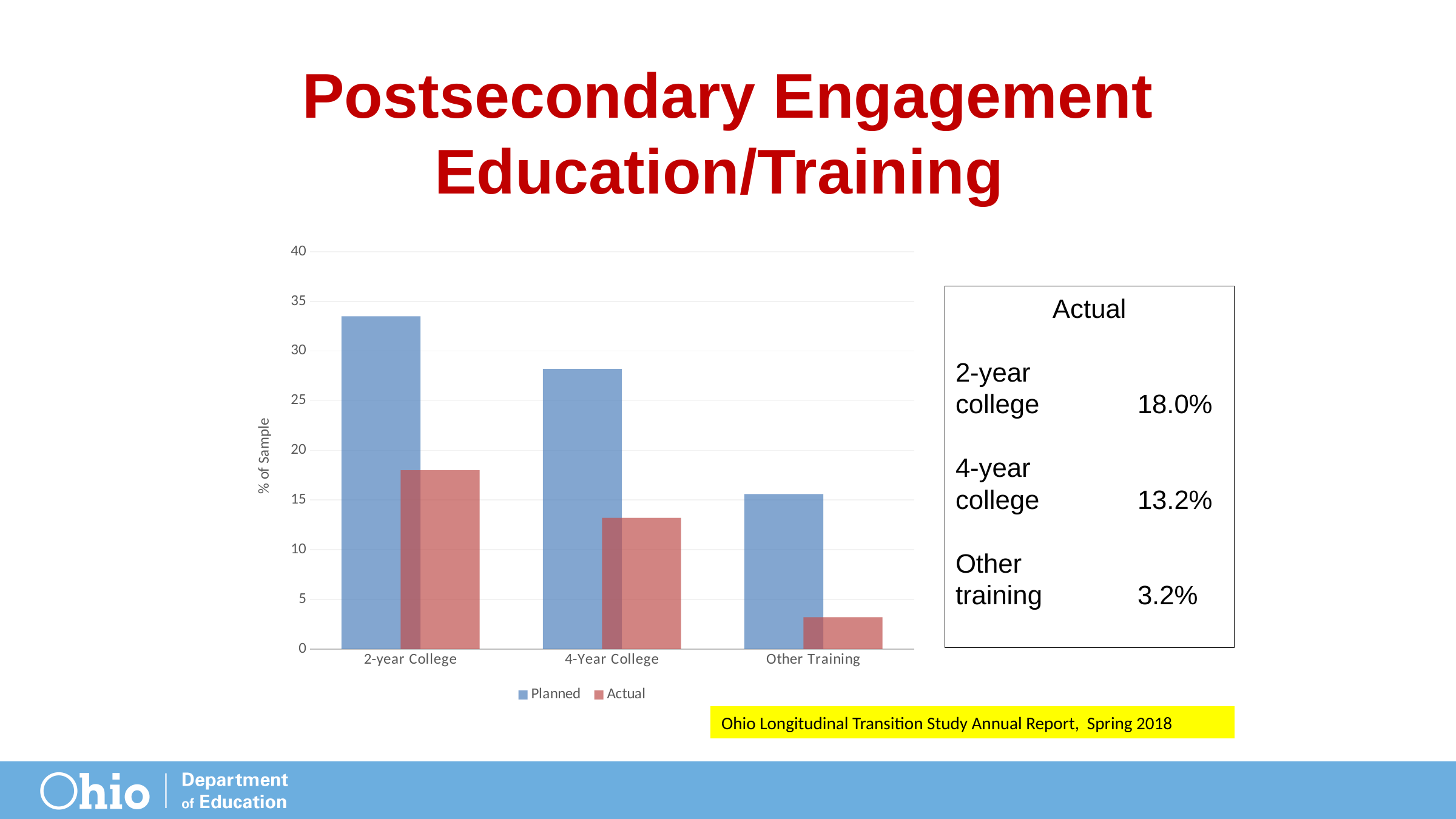
What is the Actual value for 2-year college? 18.0% Which category has the highest Actual value? 2-year College What is the Actual value for Other training? 3.2% Is the Planned value for 2-year College greater or less than 30? greater What is the difference between the Actual values for 2-year college and 4-year college? 4.8% What kind of chart is shown on the slide? bar chart For 4-Year College, which is larger, the Planned value or the Actual value? Planned Which category has the lowest Planned value? Other Training How many categories are shown on the x axis of the chart? 3 Is the Planned value for Other Training greater or less than 20? less How many series does the chart's legend list? 2 What is the Actual value for 4-year college? 13.2%